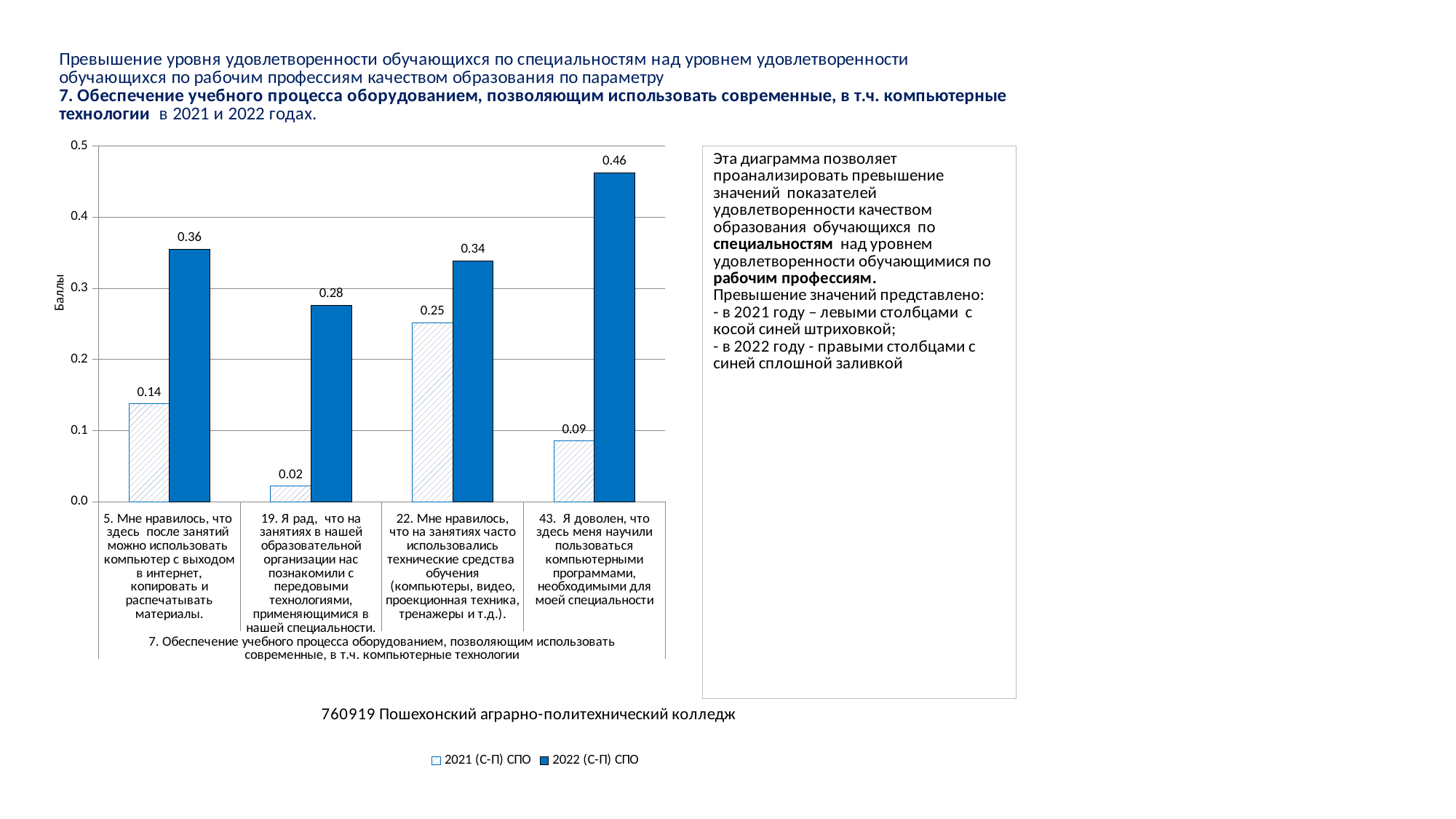
How many categories are shown on the x axis of the chart? 4 How many series does the legend list? 2 Is the 2022 (С-П) СПО value for category 19 greater or less than 0.3? less What is the value of the 2021 (С-П) СПО series for category 19 ("Я рад, что на занятиях в нашей образовательной организации нас познакомили с передовыми технологиями...")? 0.02 What kind of chart is shown on the slide? Bar chart Which category has the lowest value in the 2021 (С-П) СПО series? 19. Я рад, что на занятиях в нашей образовательной организации нас познакомили с передовыми технологиями, применяющимися в нашей специальности. What is the difference between the 2022 and 2021 values for category 5 ("Мне нравилось, что здесь после занятий можно использовать компьютер с выходом в интернет...")? 0.22 What is the label of the y axis of the chart? Баллы What is the value of the 2022 (С-П) СПО series for category 43 ("Я доволен, что здесь меня научили пользоваться компьютерными программами...")? 0.46 Which category has the highest value in the 2022 (С-П) СПО series? 43. Я доволен, что здесь меня научили пользоваться компьютерными программами, необходимыми для моей специальности Which is larger: the 2021 (С-П) СПО value for category 22 or the 2021 (С-П) СПО value for category 43? Category 22 (0.25) What is the value of the 2021 (С-П) СПО series for category 22 ("Мне нравилось, что на занятиях часто использовались технические средства обучения...")? 0.25